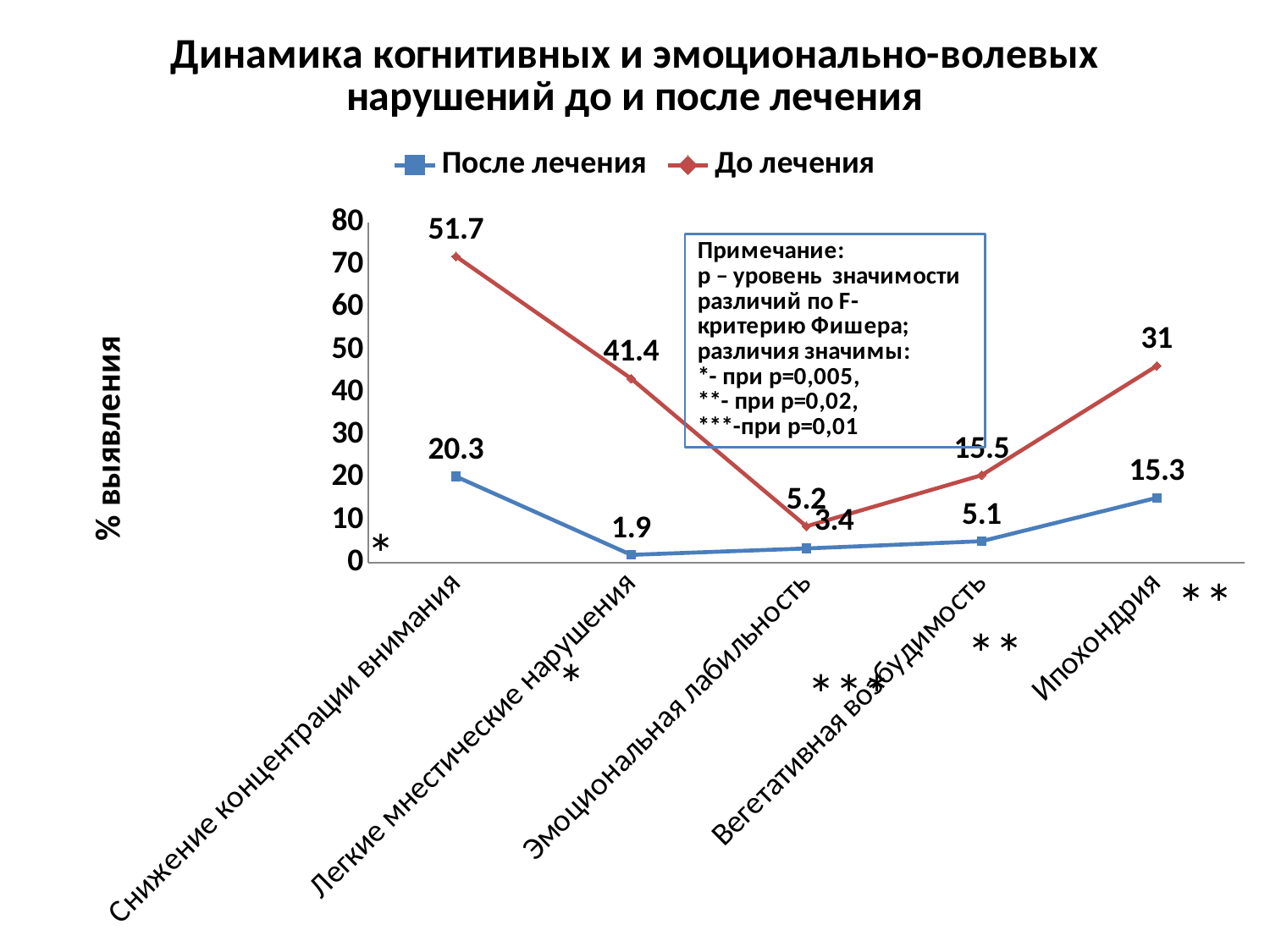
How many series does the legend list? 2 What is the value for "После лечения" at "Ипохондрия"? 15.3 How many categories are shown on the x axis? 5 Which category has the highest value for "До лечения"? Снижение концентрации внимания What is the difference between the "До лечения" and "После лечения" values at "Снижение концентрации внимания"? 31.4 What kind of chart is shown on the slide? Line chart What is the value for "После лечения" at "Легкие мнестические нарушения"? 1.9 What is the value for "До лечения" at "Эмоциональная лабильность"? 5.2 What is the value for "До лечения" at "Снижение концентрации внимания"? 51.7 What is the difference between the "До лечения" and "После лечения" values at "Ипохондрия"? 15.7 Which category has the lowest value for "После лечения"? Легкие мнестические нарушения At "Вегетативная возбудимость", which series has the larger value, "До лечения" or "После лечения"? До лечения